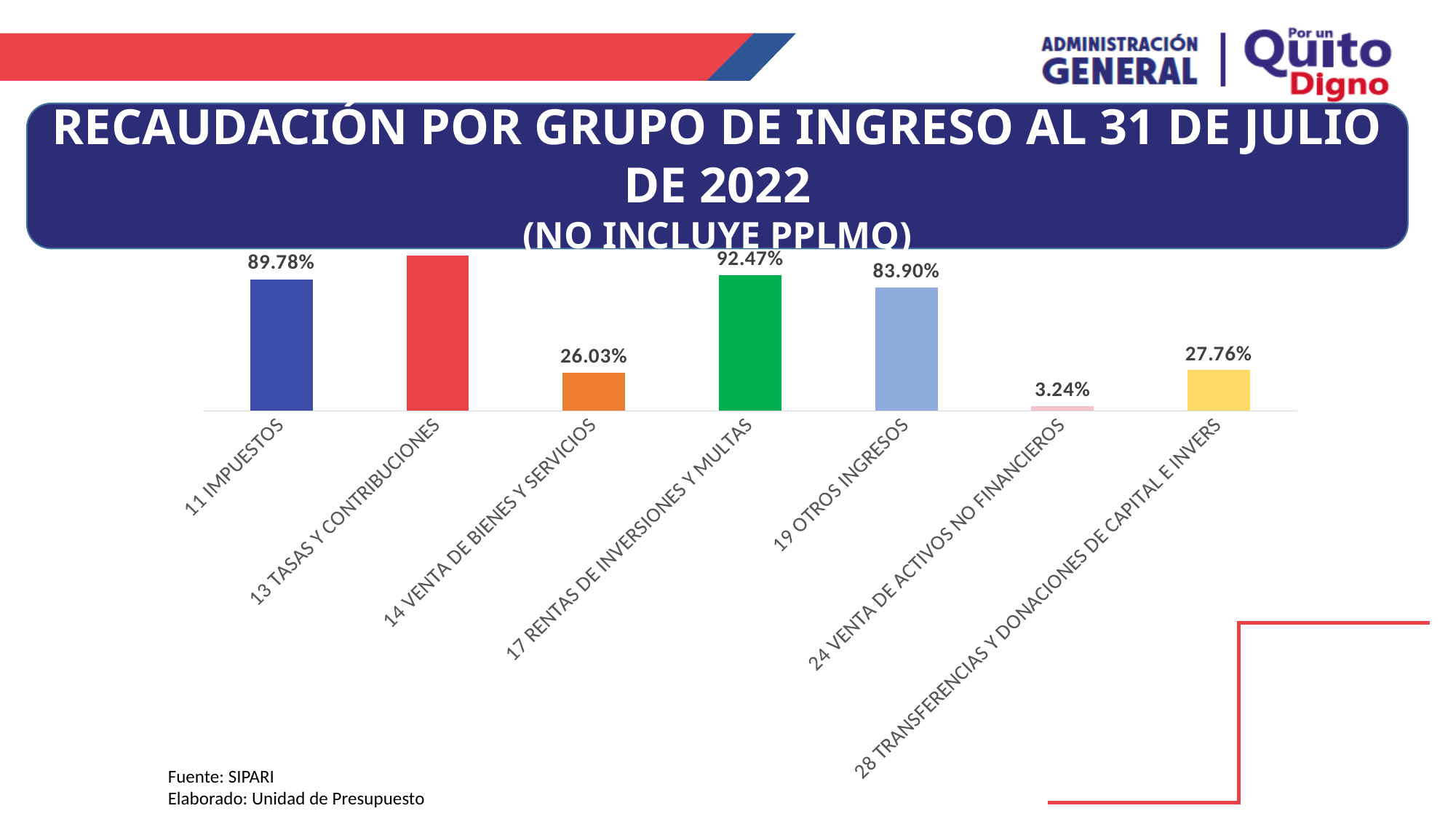
Which category has the tallest bar? 13 TASAS Y CONTRIBUCIONES What is the value for 19 OTROS INGRESOS? 83.90% What is the difference between the values for 17 RENTAS DE INVERSIONES Y MULTAS and 11 IMPUESTOS? 2.69% What is the value for 28 TRANSFERENCIAS Y DONACIONES DE CAPITAL E INVERS? 27.76% What is the value for 17 RENTAS DE INVERSIONES Y MULTAS? 92.47% What is the value for 24 VENTA DE ACTIVOS NO FINANCIEROS? 3.24% How many categories are shown in the chart? 7 What is the difference between the values for 11 IMPUESTOS and 19 OTROS INGRESOS? 5.88% Which category has the lowest value? 24 VENTA DE ACTIVOS NO FINANCIEROS Which is larger, the value for 14 VENTA DE BIENES Y SERVICIOS or the value for 28 TRANSFERENCIAS Y DONACIONES DE CAPITAL E INVERS? 28 TRANSFERENCIAS Y DONACIONES DE CAPITAL E INVERS What is the value for 11 IMPUESTOS? 89.78% What kind of chart is shown on the slide? Bar chart